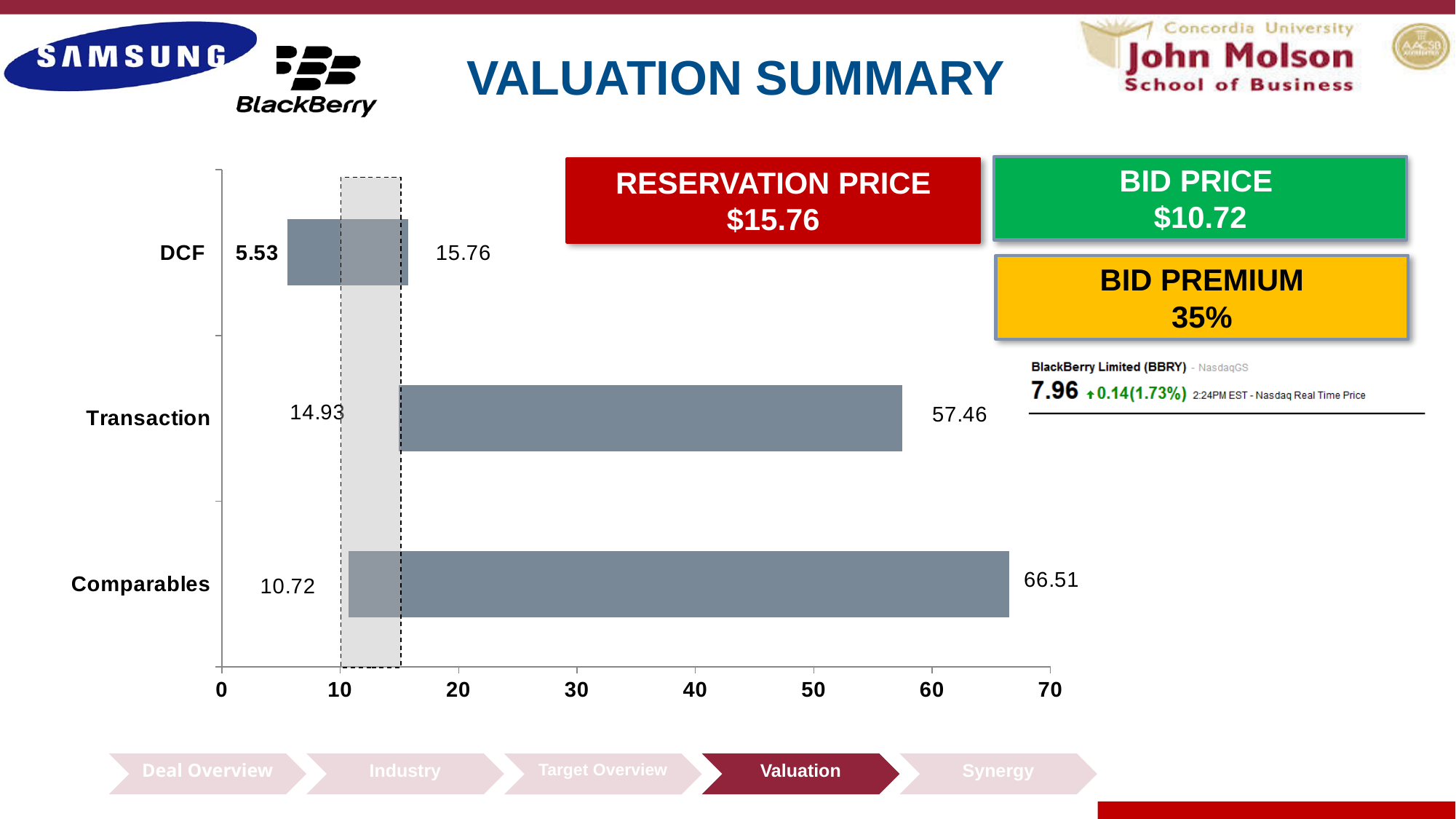
What is the low end of the Transaction valuation range? 14.93 What is the high end of the Comparables valuation range? 66.51 How many valuation methods are shown on the chart? 3 Which is larger, the high end of the Transaction range or the high end of the Comparables range? Comparables What is the low end of the DCF valuation range? 5.53 What type of chart is used to show the valuation ranges? bar chart What is the high end of the DCF valuation range? 15.76 What is the difference between the high and low ends of the Transaction range? 42.53 Is the high end of the Transaction range greater or less than 50? greater Which valuation method has the lowest lower value? DCF Which valuation method has the highest upper value? Comparables What is the maximum value shown on the horizontal axis? 70